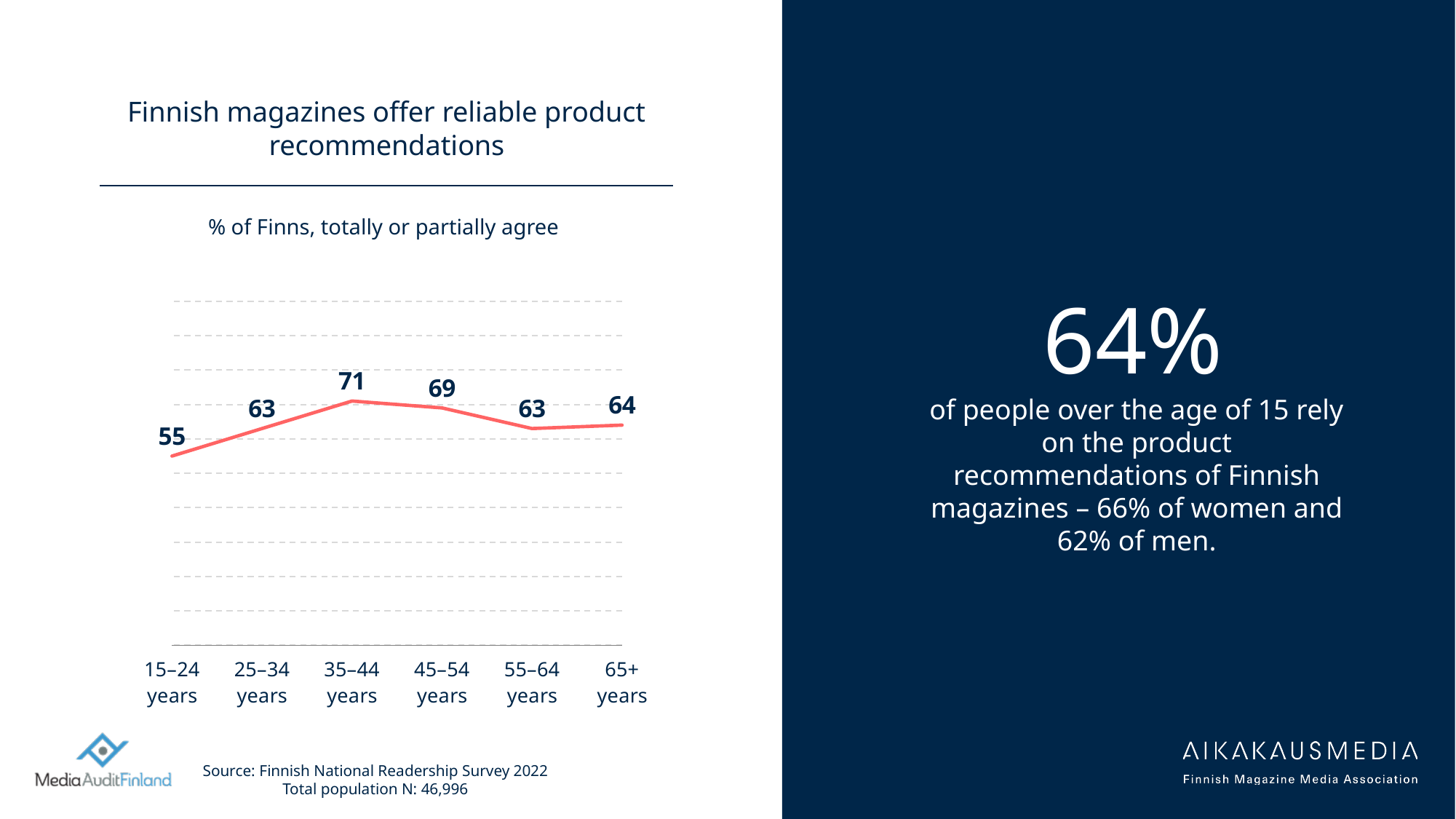
Does the value rise or fall from 15–24 years to 35–44 years? Rise What is the value for the 65+ years age group? 64 What kind of chart is shown on the slide? Line chart Which age group has the lowest value? 15–24 years What is the difference between the values for 45–54 years and 55–64 years? 6 Which is larger, the value for 45–54 years or the value for 65+ years? 45–54 years How many age groups are plotted on the chart? 6 What is the value for the 35–44 years age group? 71 What is the difference between the values for 35–44 years and 15–24 years? 16 Which age group has the highest value? 35–44 years What is the title of the chart? Finnish magazines offer reliable product recommendations What is the value for the 15–24 years age group? 55